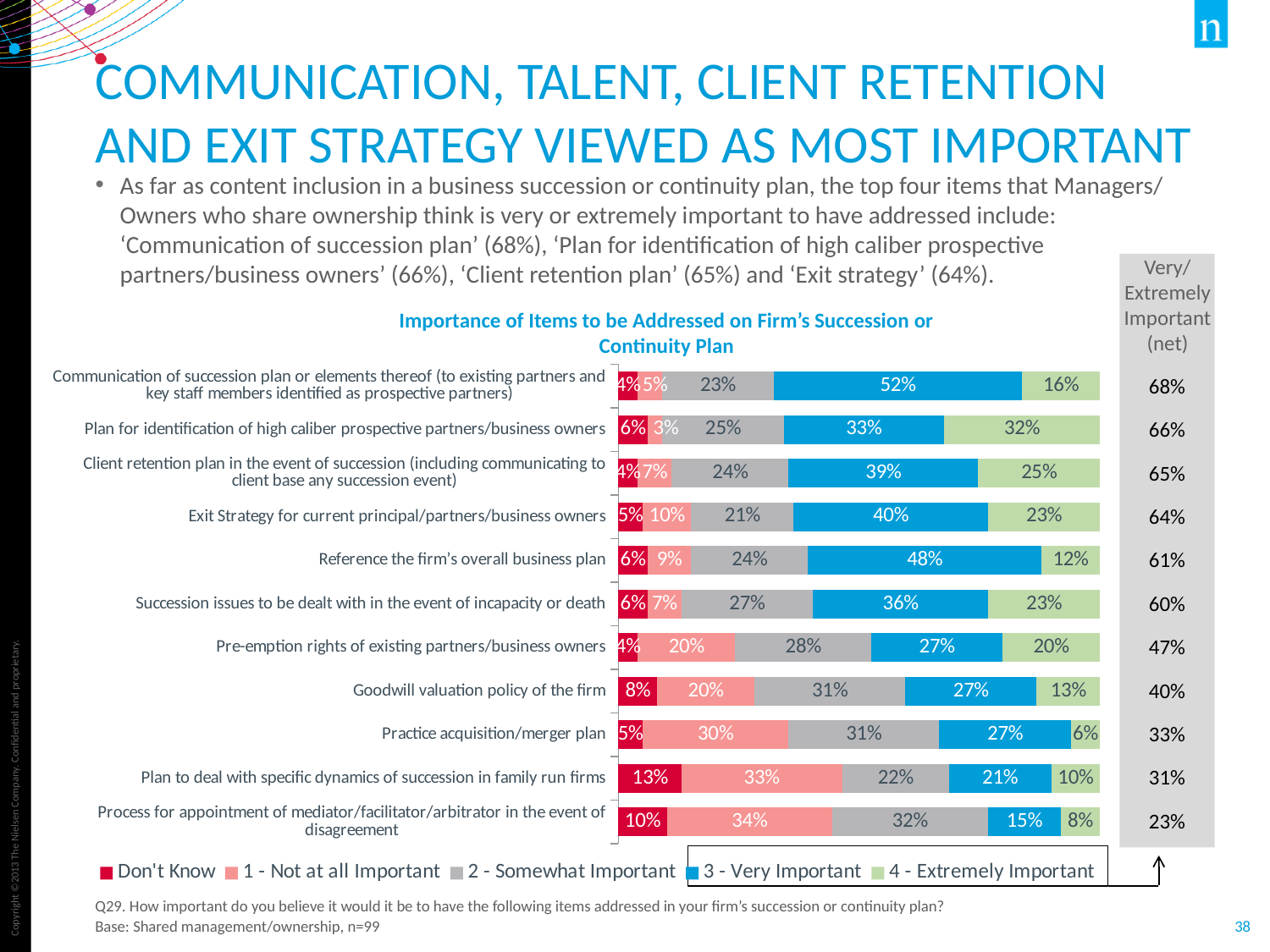
What is the difference between the 1 - Not at all Important percentages for 'Process for appointment of mediator/facilitator/arbitrator' and 'Goodwill valuation policy of the firm'? 14% What percentage answered 'Don't Know' for 'Plan to deal with specific dynamics of succession in family run firms'? 13% What percentage rated 'Plan for identification of high caliber prospective partners/business owners' as 4 - Extremely Important? 32% What type of chart is shown on the slide? Stacked bar chart How many items (categories) are plotted in the chart? 11 Which item has the lowest Very/Extremely Important (net) value? Process for appointment of mediator/facilitator/arbitrator in the event of disagreement Which item has the highest share of 3 - Very Important responses? Communication of succession plan or elements thereof What percentage rated 'Communication of succession plan or elements thereof' as 3 - Very Important? 52% Which has a larger 2 - Somewhat Important share: 'Goodwill valuation policy of the firm' or 'Exit Strategy for current principal/partners/business owners'? Goodwill valuation policy of the firm What is the title of the chart? Importance of Items to be Addressed on Firm's Succession or Continuity Plan What is the Very/Extremely Important (net) value for 'Exit Strategy for current principal/partners/business owners'? 64% How many series does the legend list? 5